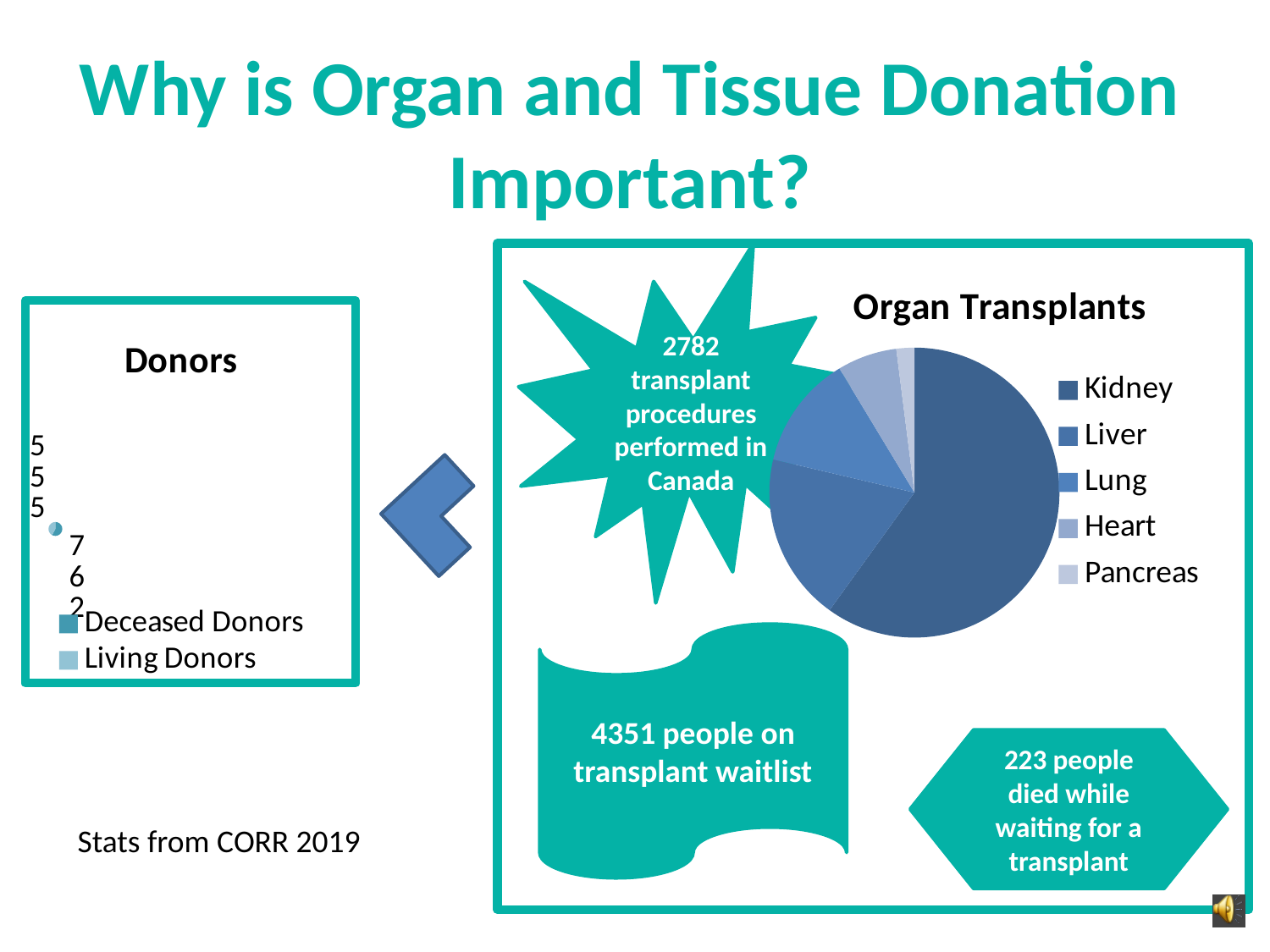
In the Organ Transplants chart, which slice is larger, Kidney or Liver? Kidney How many entries does the legend of the Donors chart list? 2 What kind of chart is the Donors chart? Pie chart What are the legend entries of the Organ Transplants chart? Kidney, Liver, Lung, Heart, Pancreas What kind of chart is the Organ Transplants chart? Pie chart In the Organ Transplants chart, which slice is larger, Heart or Pancreas? Heart In the Organ Transplants chart, which organ has the largest slice? Kidney In the Organ Transplants chart, which organ has the smallest slice? Pancreas In the Organ Transplants chart, which slice is larger, Liver or Lung? Liver What is the title of the chart on the left side of the slide? Donors How many categories does the Organ Transplants pie chart show? 5